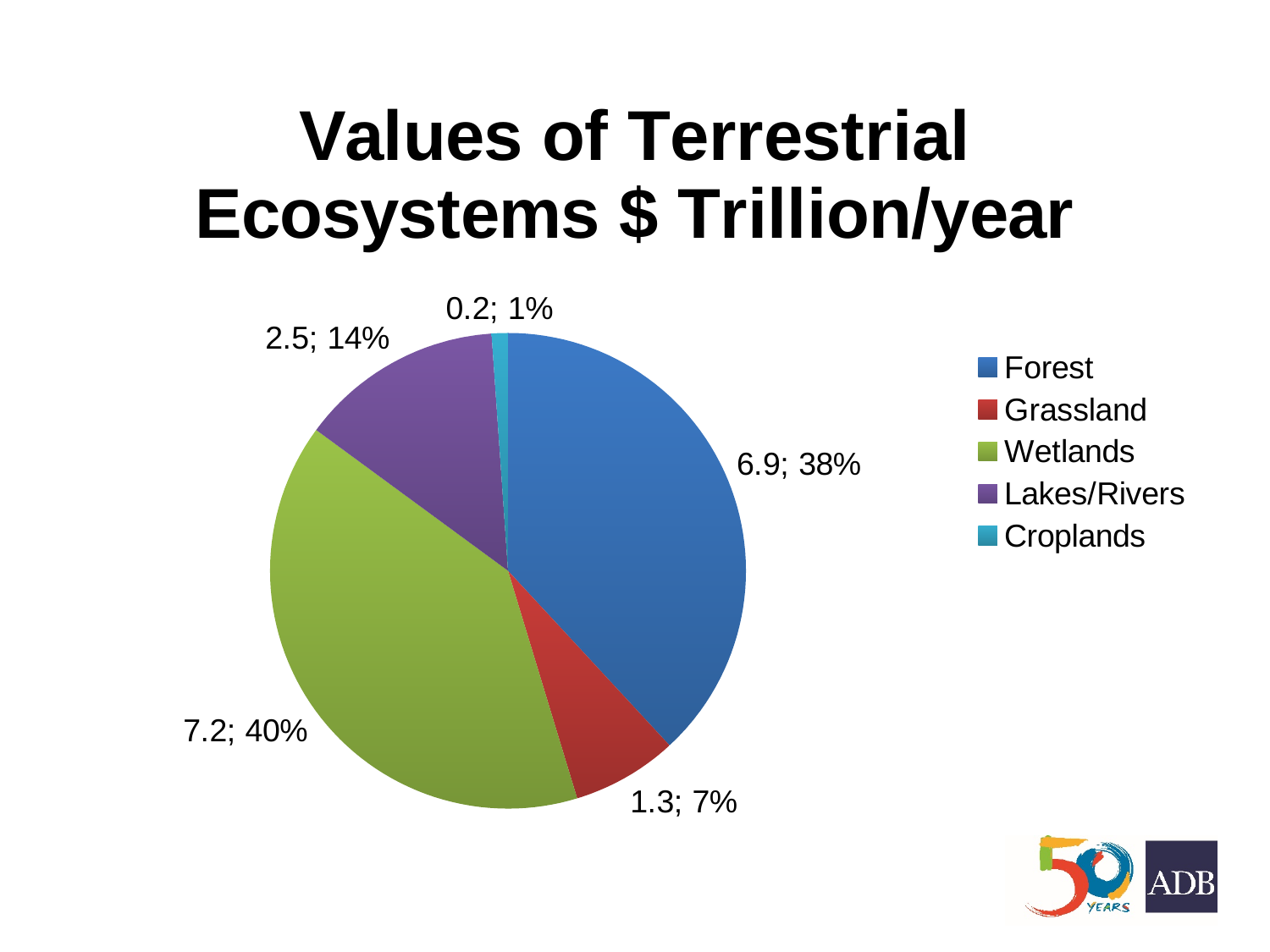
What kind of chart is shown on the slide? pie chart What is the difference between the values for Lakes/Rivers and Grassland? 1.2 What share of the pie does Grassland represent? 7% What is the value for Forest? 6.9 What is the value for Croplands? 0.2 What is the value for Wetlands? 7.2 Which category has the largest slice? Wetlands What share of the pie does Forest represent? 38% Which is larger, the value for Forest or the value for Lakes/Rivers? Forest How many categories does the legend list? 5 What is the value for Lakes/Rivers? 2.5 Which category has the smallest slice? Croplands